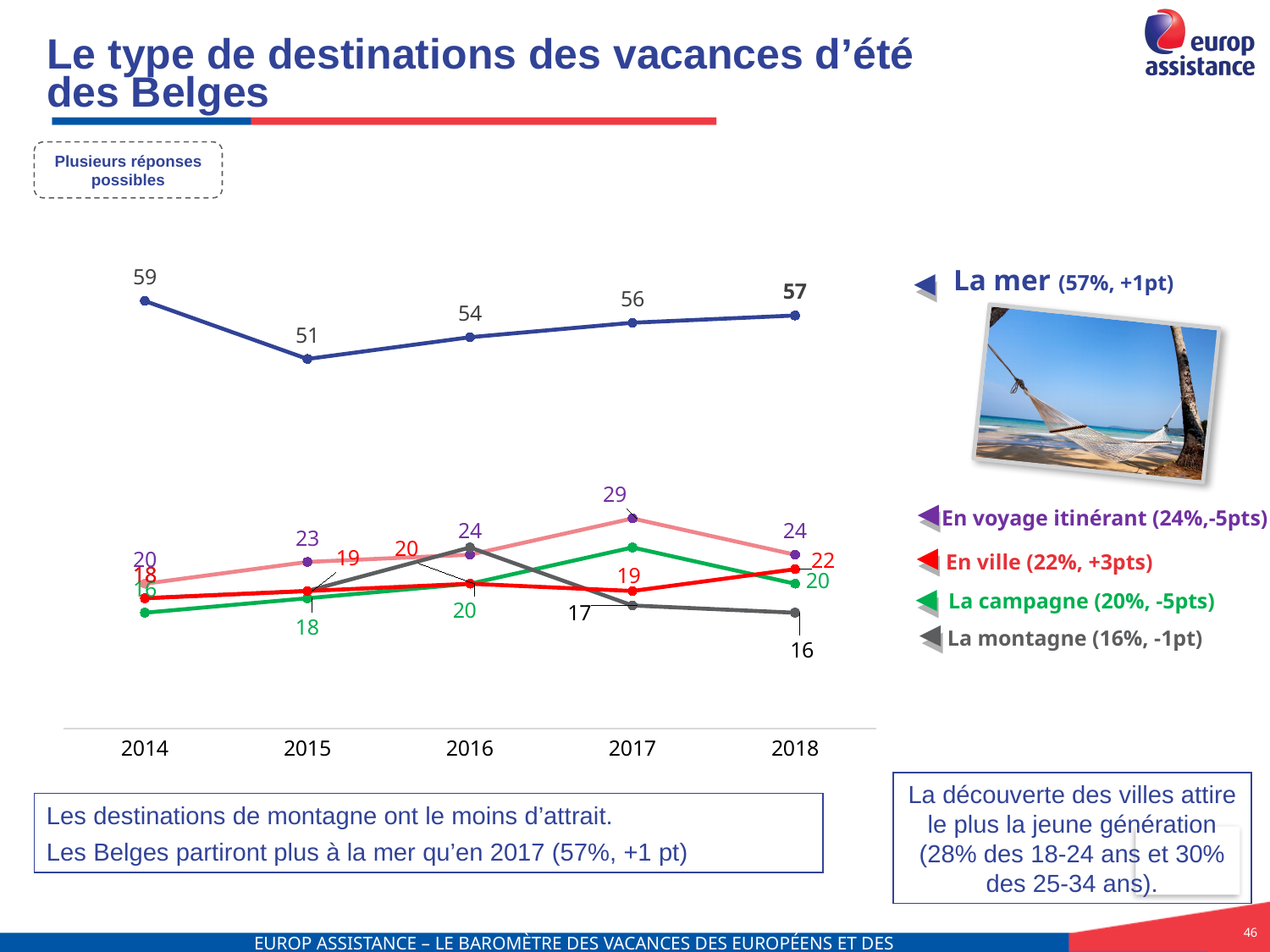
Which is larger in 2018, La mer or En voyage itinérant? La mer What value does La montagne have in 2018? 16 In which year is the value for La mer highest? 2014 What value does La mer have in 2018? 57 In which year is the value for La mer lowest? 2015 What is the difference between En ville and La montagne in 2018? 6 Which destination type has the lowest value in 2018? La montagne What is the difference between the La mer values in 2014 and 2015? 8 What value does En voyage itinérant have in 2017? 29 What value does La mer have in 2014? 59 How many years are shown on the x axis? 5 What kind of chart is shown on the slide? Line chart